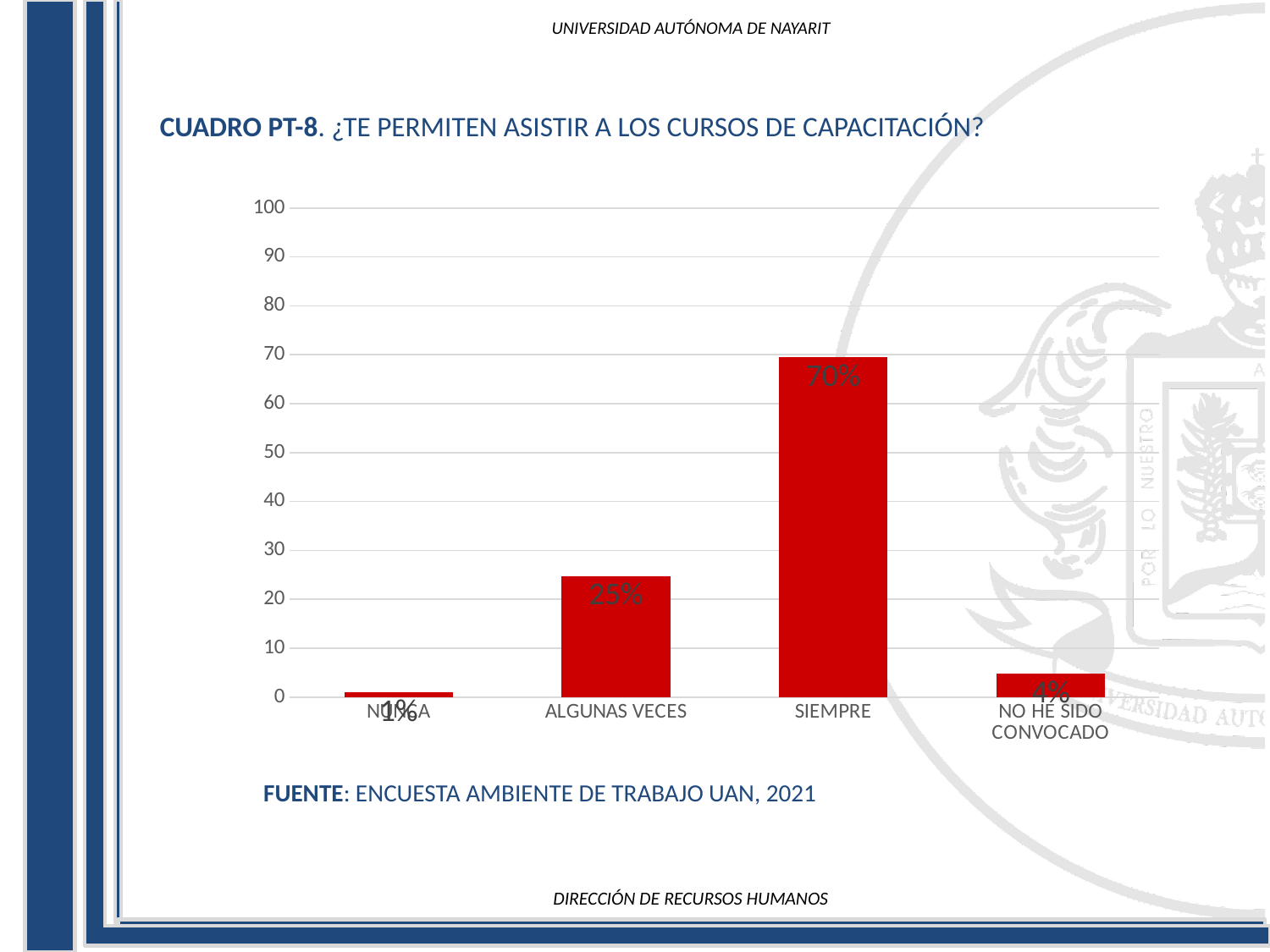
What is the source cited below the chart? ENCUESTA AMBIENTE DE TRABAJO UAN, 2021 What is the value for NO HE SIDO CONVOCADO? 4% What is the value for ALGUNAS VECES? 25% How many categories are shown on the x axis of the chart? 4 Is the value for SIEMPRE greater or less than 60? greater What is the value for SIEMPRE? 70% Is the value for ALGUNAS VECES greater or less than 30? less What kind of chart is shown on the slide? bar chart Which category has the highest value? SIEMPRE What is the difference between the values for SIEMPRE and ALGUNAS VECES? 45% Which is larger, the value for ALGUNAS VECES or the value for NO HE SIDO CONVOCADO? ALGUNAS VECES Which category has the lowest value? NUNCA